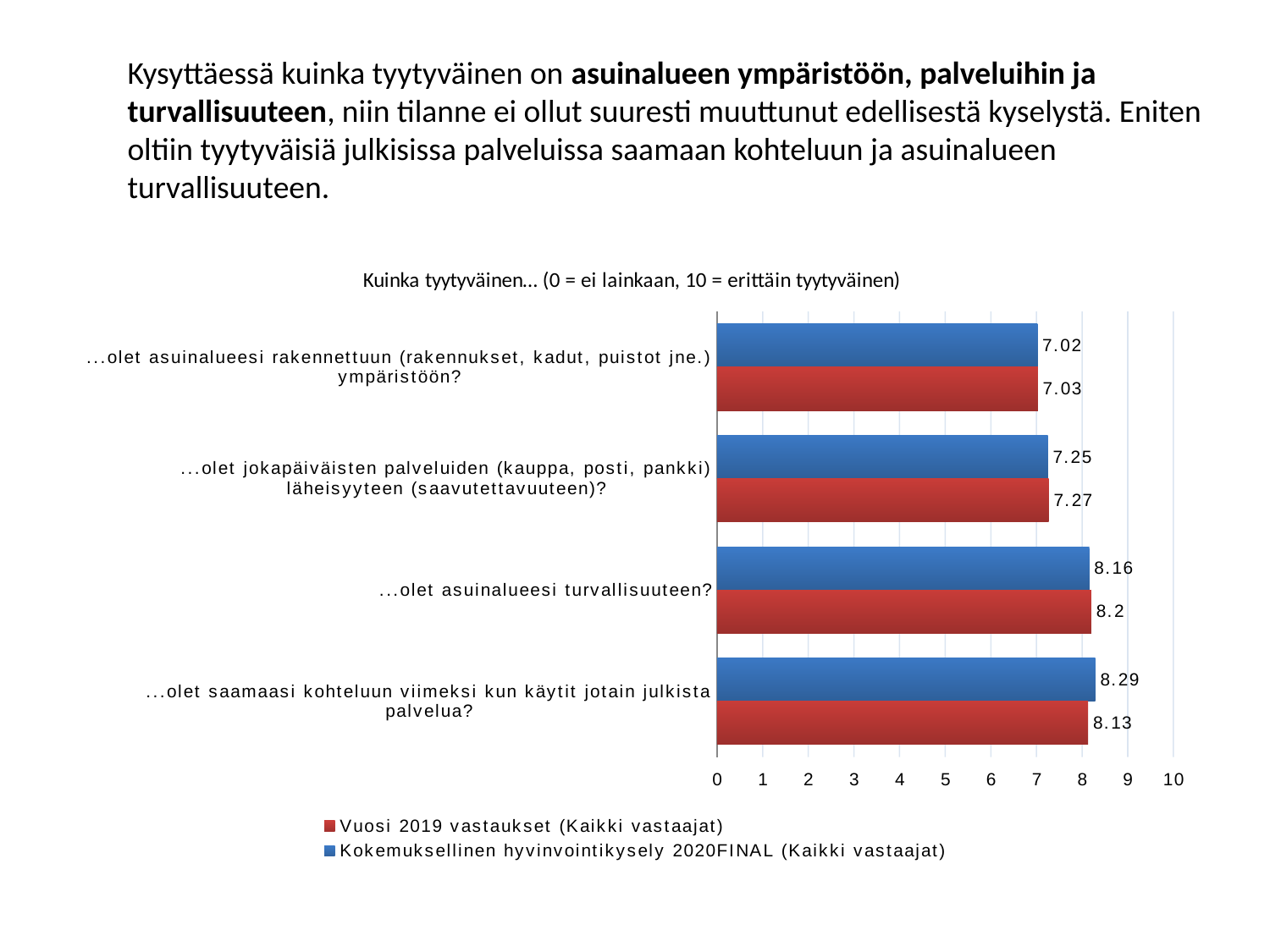
Which category has the highest value in the Kokemuksellinen hyvinvointikysely 2020FINAL series? ...olet saamaasi kohteluun viimeksi kun käytit jotain julkista palvelua? How many categories are shown on the chart? 4 Which category has the lowest value in the Vuosi 2019 vastaukset series? ...olet asuinalueesi rakennettuun (rakennukset, kadut, puistot jne.) ympäristöön? Is the 2019 value for "...olet jokapäiväisten palveluiden (kauppa, posti, pankki) läheisyyteen (saavutettavuuteen)?" greater or less than 8? less What kind of chart is shown on the slide? bar chart What is the 2019 value for "...olet asuinalueesi turvallisuuteen?"? 8.2 How many series does the legend list? 2 What is the Kokemuksellinen hyvinvointikysely 2020FINAL value for "...olet saamaasi kohteluun viimeksi kun käytit jotain julkista palvelua?"? 8.29 For "...olet asuinalueesi turvallisuuteen?", which series has the larger value, Vuosi 2019 or 2020FINAL? Vuosi 2019 vastaukset (Kaikki vastaajat) What is the difference between the 2020FINAL and 2019 values for "...olet saamaasi kohteluun viimeksi kun käytit jotain julkista palvelua?"? 0.16 What is the Vuosi 2019 value for "...olet jokapäiväisten palveluiden (kauppa, posti, pankki) läheisyyteen (saavutettavuuteen)?"? 7.27 What is the 2020FINAL value for "...olet asuinalueesi rakennettuun (rakennukset, kadut, puistot jne.) ympäristöön?"? 7.02